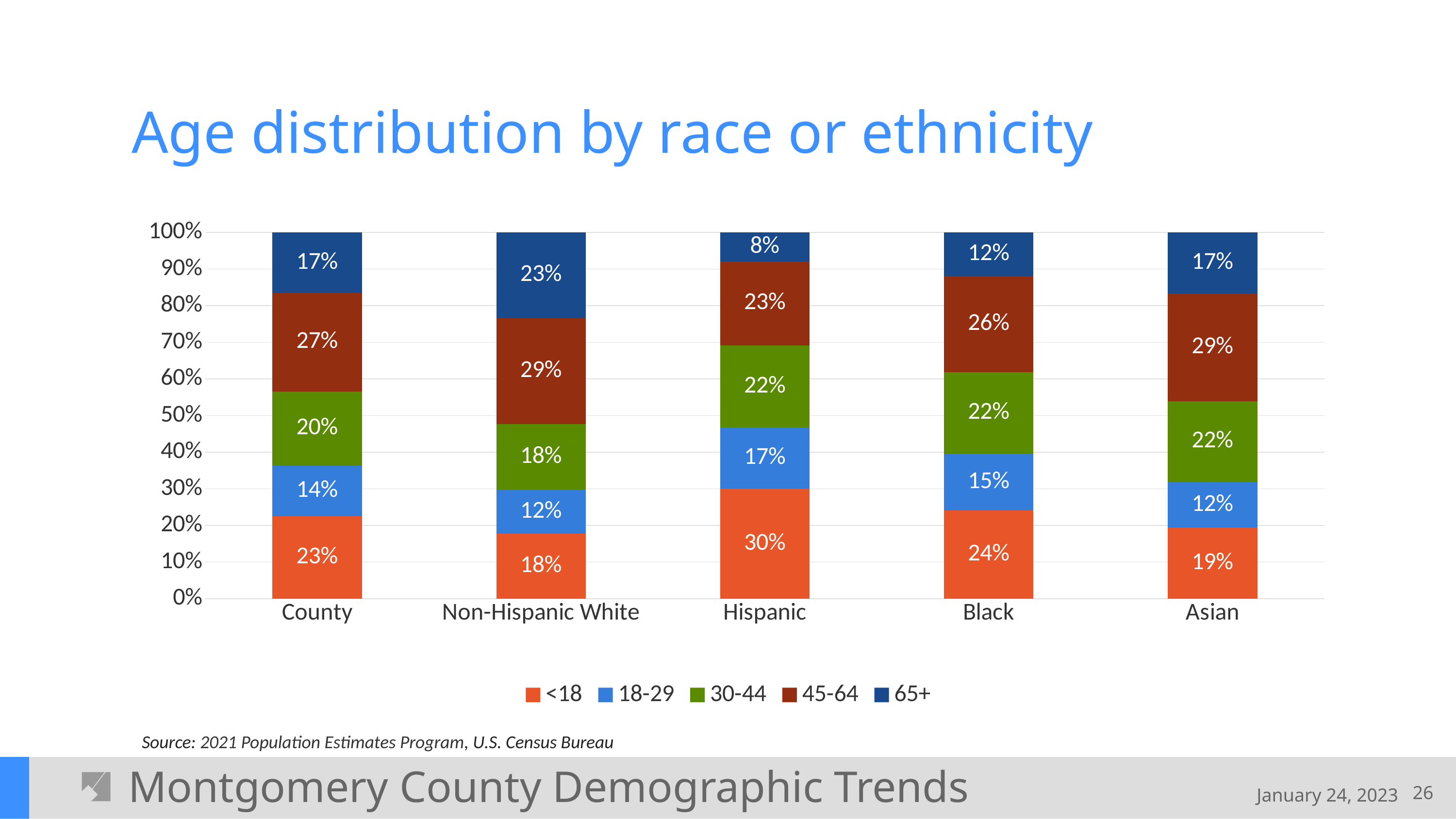
Which group has the highest share of people under 18? Hispanic What kind of chart is shown on the slide? Stacked bar chart What is the 45-64 share for Black? 26% What is the difference between the 65+ share for Non-Hispanic White and the 65+ share for Hispanic? 15% How many race or ethnicity categories are shown on the x axis? 5 What is the 18-29 share for the County? 14% What is the title of the chart? Age distribution by race or ethnicity Which is larger: the <18 share for Black or the <18 share for Asian? Black What is the 65+ share for Non-Hispanic White? 23% What percentage of the Hispanic population is under 18? 30% How many age groups does the legend list? 5 Which group has the lowest share of people aged 65+? Hispanic